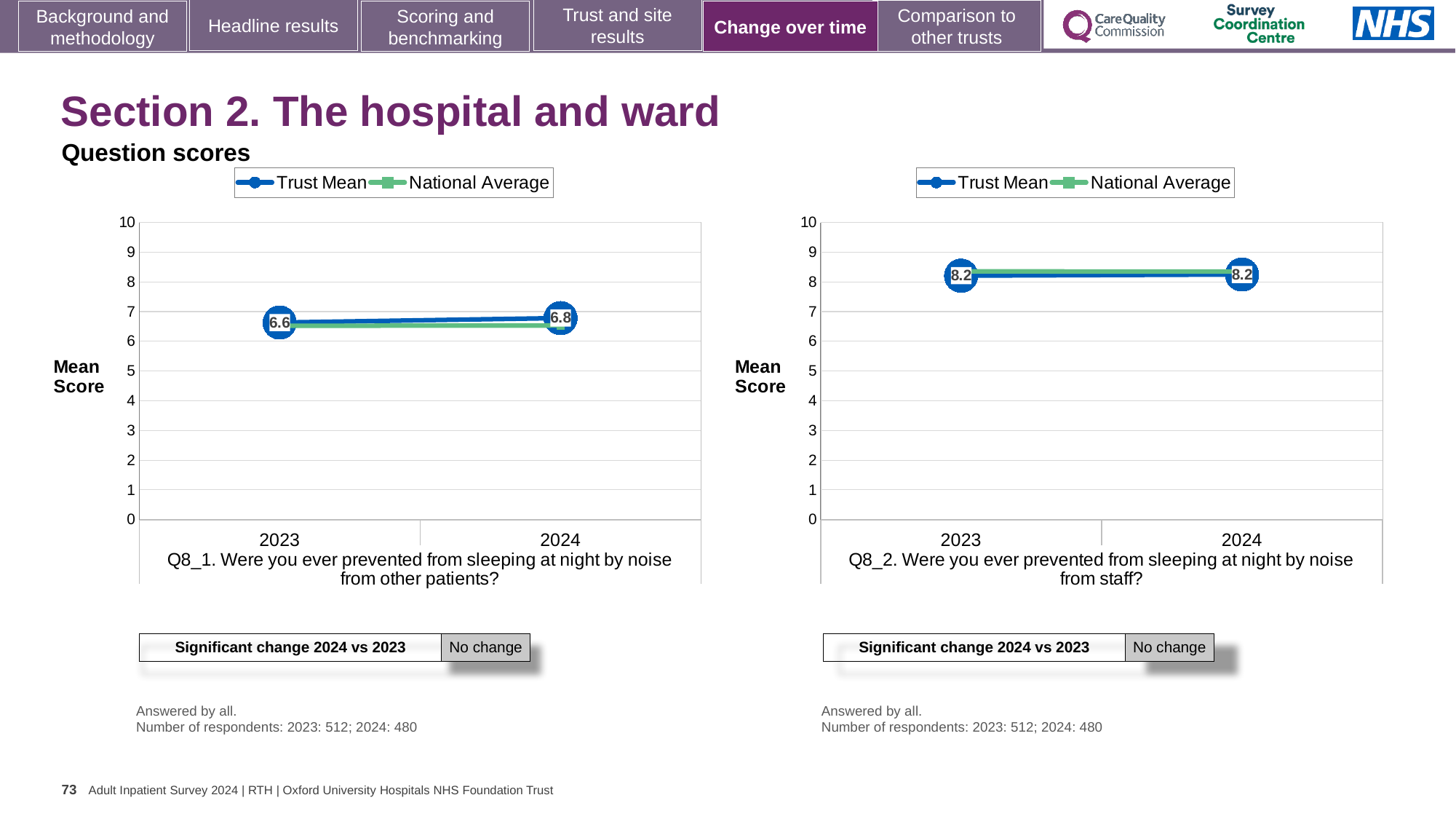
In the Q8_1 chart (left), what is the Trust Mean score for 2023? 6.6 In the Q8_2 chart (right), what is the Trust Mean score for 2024? 8.2 In the Q8_2 chart (right), does the Trust Mean rise, fall or stay the same from 2023 to 2024? stays the same In the Q8_2 chart (right), what is the Trust Mean score for 2023? 8.2 In the Q8_1 chart (left), does the Trust Mean rise or fall from 2023 to 2024? rise In the Q8_1 chart (left), what is the Trust Mean score for 2024? 6.8 What is the label on the y axis of the Q8_1 chart (left)? Mean Score How many series does the legend of the Q8_2 chart (right) list? 2 What kind of chart is the Q8_1 chart on the left? line chart In the Q8_1 chart (left), by how much did the Trust Mean change from 2023 to 2024? 0.2 How many years are shown on the x axis of the Q8_1 chart (left)? 2 In the Q8_2 chart (right), is the National Average value for 2024 greater or less than 7? greater